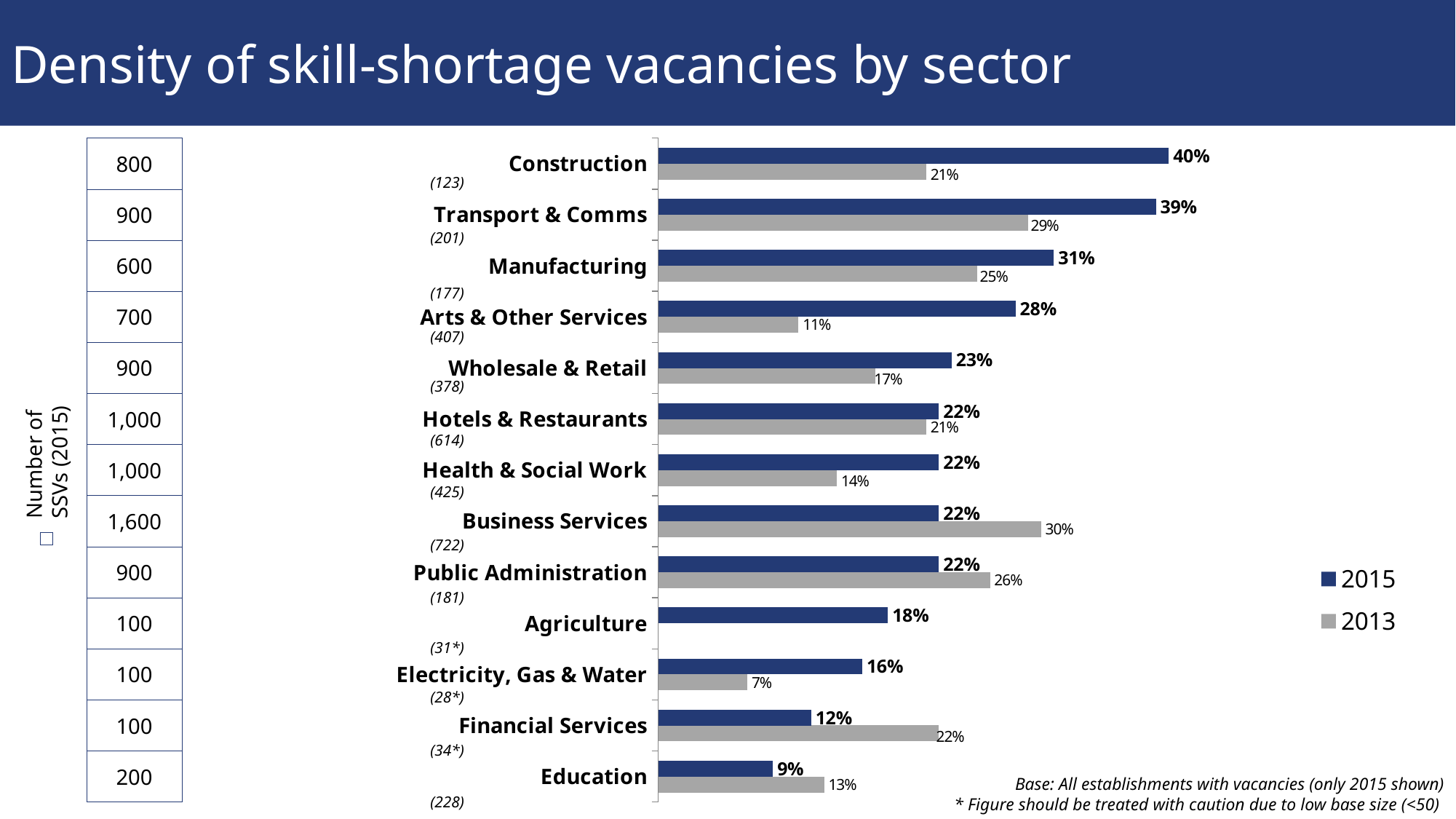
What kind of chart is shown on the slide? Bar chart What is the 2013 value for Electricity, Gas & Water? 7% What is the difference between the 2015 and 2013 values for Arts & Other Services? 17 percentage points Which sector has the highest 2013 value? Business Services Which sector has the highest 2015 value? Construction Which colour represents the 2013 series in the chart? Grey What is the 2013 value for Business Services? 30% How many series does the legend list? 2 How many sectors are shown in the chart? 13 What is the 2015 skill-shortage vacancy density for Construction? 40% For Financial Services, which year has the larger value, 2015 or 2013? 2013 Which sector has the lowest 2015 value? Education